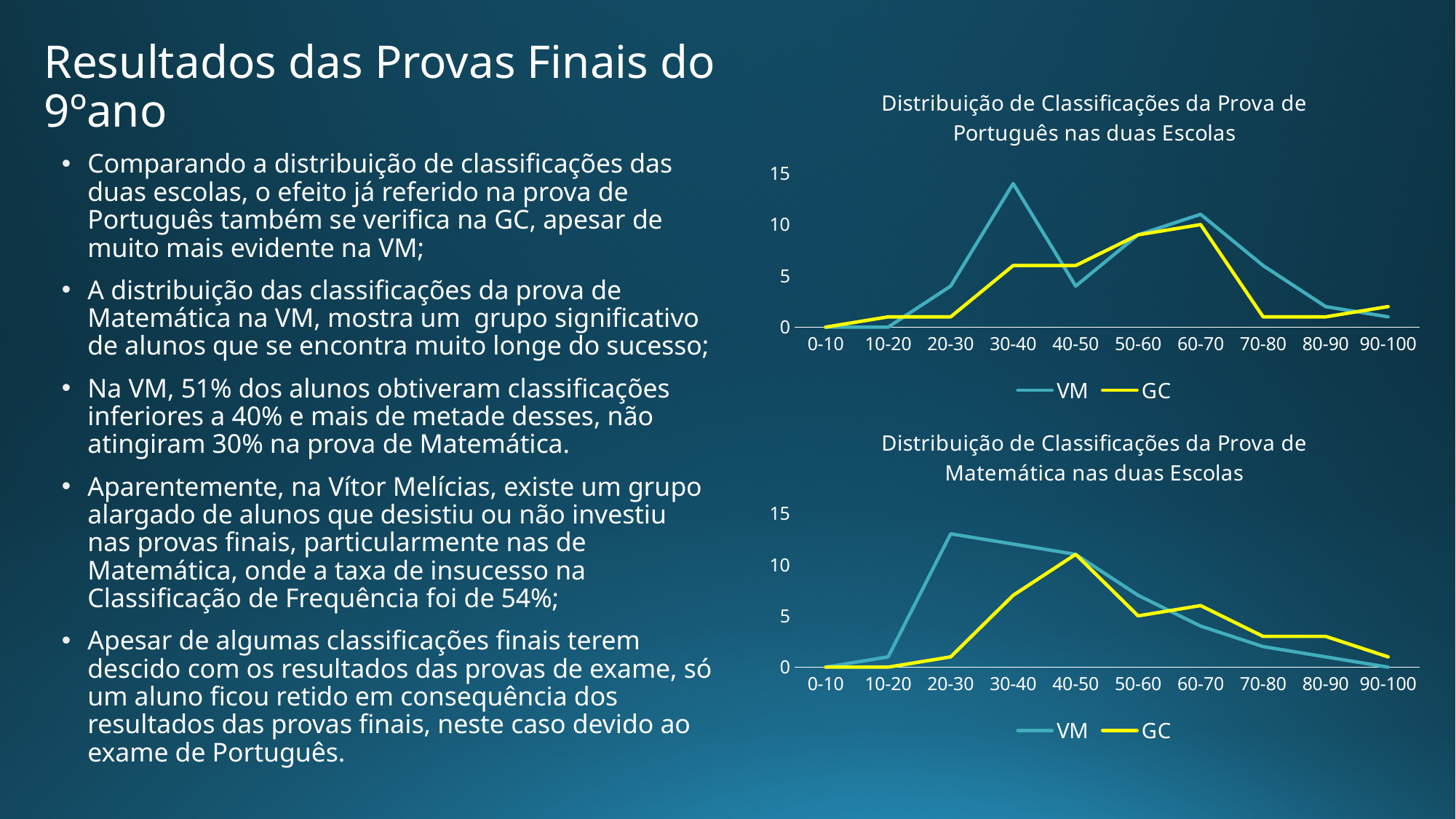
In the 'Distribuição de Classificações da Prova de Português nas duas Escolas' chart, is the VM value for 40-50 greater or less than 5? less In the 'Distribuição de Classificações da Prova de Matemática nas duas Escolas' chart, in which interval does the VM series reach its highest value? 20-30 In the 'Distribuição de Classificações da Prova de Matemática nas duas Escolas' chart, what colour is the GC line? yellow How many score intervals are shown on the x axis of the 'Distribuição de Classificações da Prova de Português nas duas Escolas' chart? 10 In the 'Distribuição de Classificações da Prova de Português nas duas Escolas' chart, is the VM value for 30-40 greater or less than 10? greater In the 'Distribuição de Classificações da Prova de Português nas duas Escolas' chart, in which interval does the VM series reach its highest value? 30-40 In the 'Distribuição de Classificações da Prova de Matemática nas duas Escolas' chart, which series has the larger value at 60-70, VM or GC? GC In the 'Distribuição de Classificações da Prova de Português nas duas Escolas' chart, which series has the larger value at 30-40, VM or GC? VM In the 'Distribuição de Classificações da Prova de Matemática nas duas Escolas' chart, is the GC value for 30-40 greater or less than 5? greater How many series does the legend of the 'Distribuição de Classificações da Prova de Matemática nas duas Escolas' chart list? 2 What kind of chart is the 'Distribuição de Classificações da Prova de Português nas duas Escolas' chart? line chart In the 'Distribuição de Classificações da Prova de Matemática nas duas Escolas' chart, in which interval does the GC series reach its highest value? 40-50